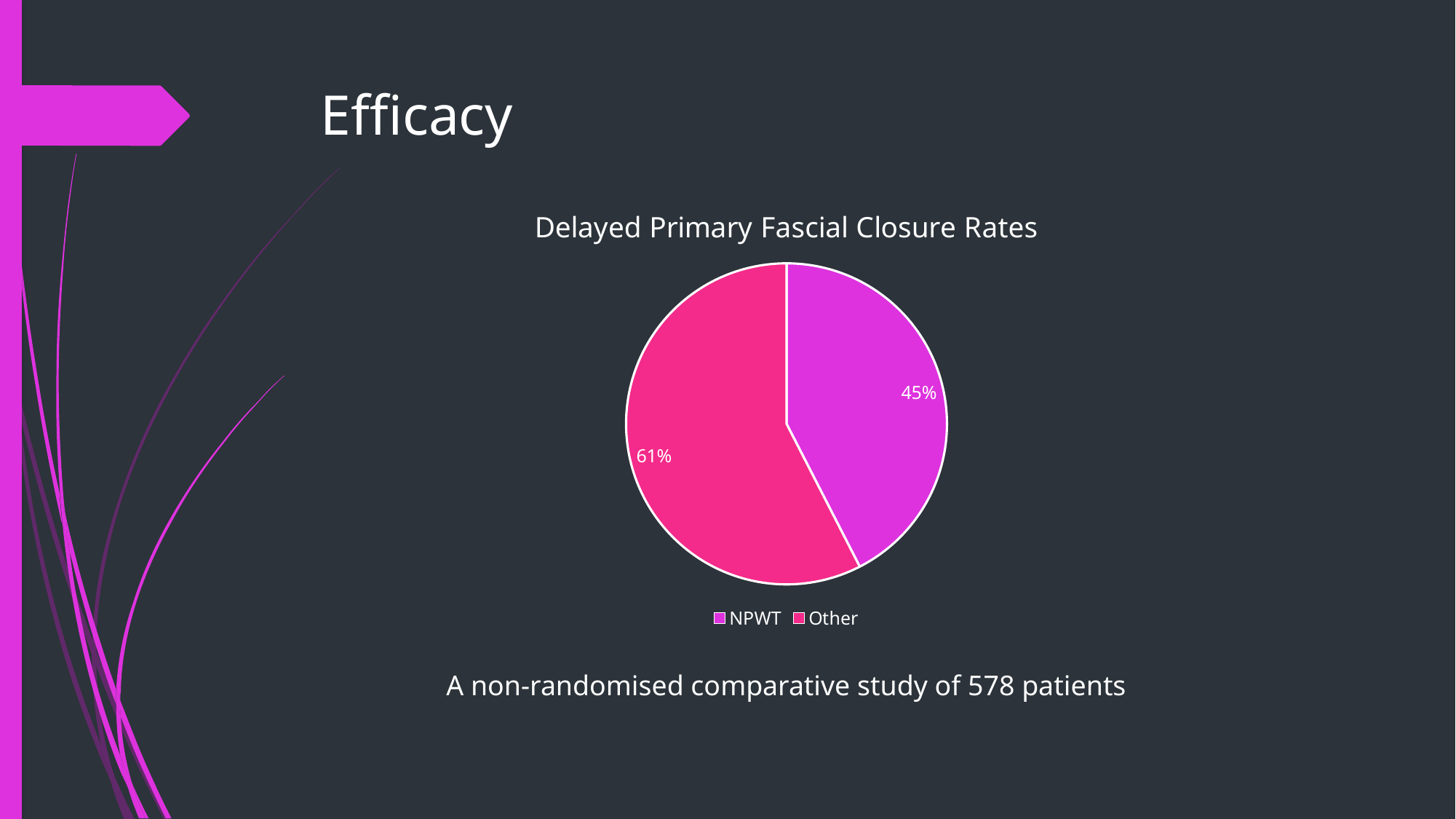
Which legend entry is shown in the purple colour? NPWT What is the title of the chart? Delayed Primary Fascial Closure Rates What is the difference between the Other value and the NPWT value? 16 percentage points How many slices does the pie chart have? 2 Which category has the larger slice in the pie chart? Other What type of chart is shown on the slide? Pie chart What value is shown for NPWT in the pie chart? 45% Is the value for Other larger or smaller than the value for NPWT? Larger What value is shown for Other in the pie chart? 61% Which category has the smaller slice in the pie chart? NPWT How many entries does the legend list? 2